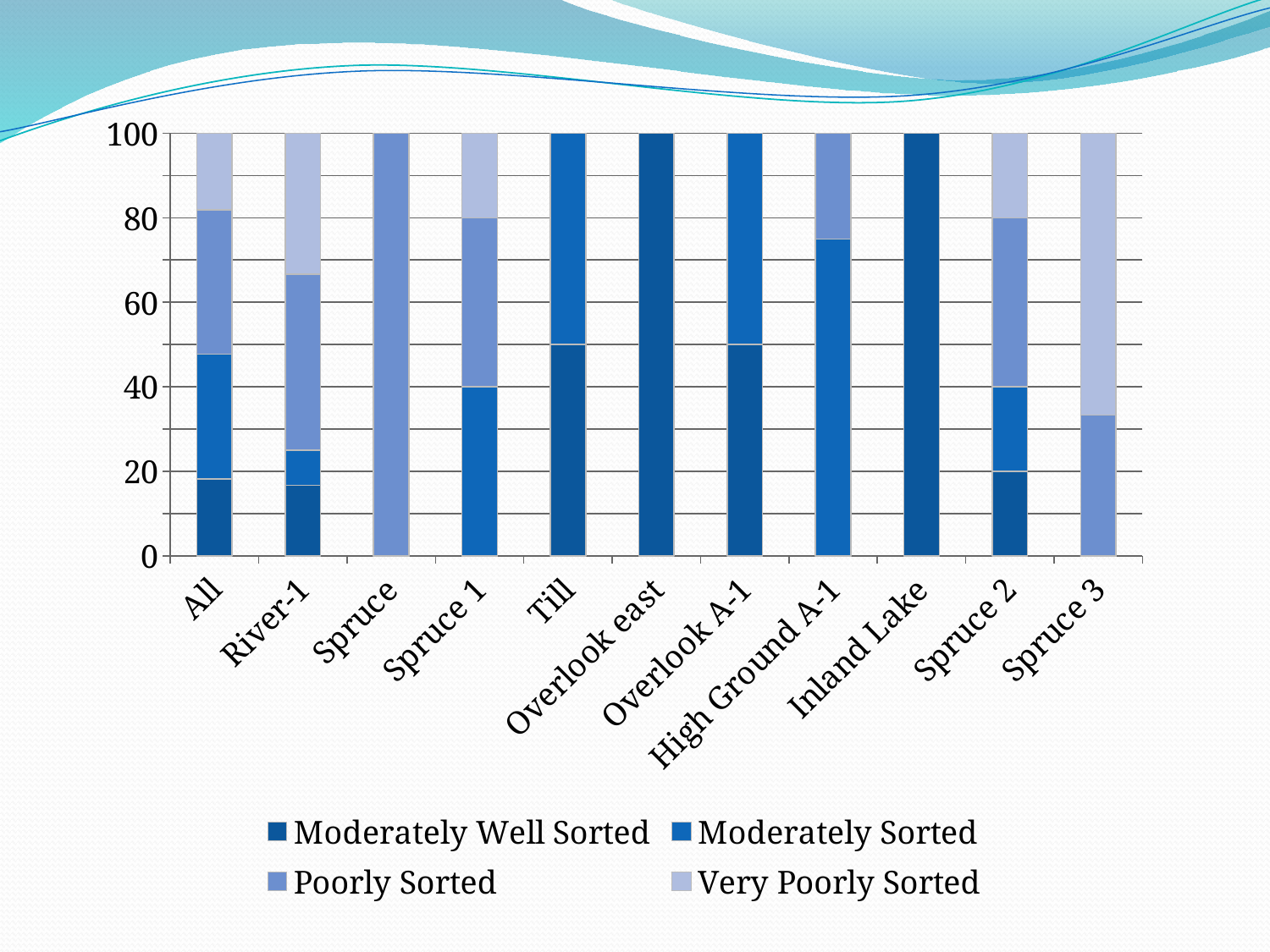
Which category has the largest Poorly Sorted segment? Spruce What is the total height of the stacked bar for River-1? 100 How many categories are shown along the x axis? 11 Is the Moderately Well Sorted value for Till greater or less than 40? greater Which category has the largest Very Poorly Sorted segment? Spruce 3 What is the value of Moderately Well Sorted for Inland Lake? 100 Which is larger, the Moderately Well Sorted value for Till or for All? Till Is the Poorly Sorted value for Spruce 3 greater or less than 40? less What is the value of Poorly Sorted for Spruce? 100 How many series does the legend list? 4 What kind of chart is shown on the slide? stacked bar chart Which series is listed last in the legend? Very Poorly Sorted